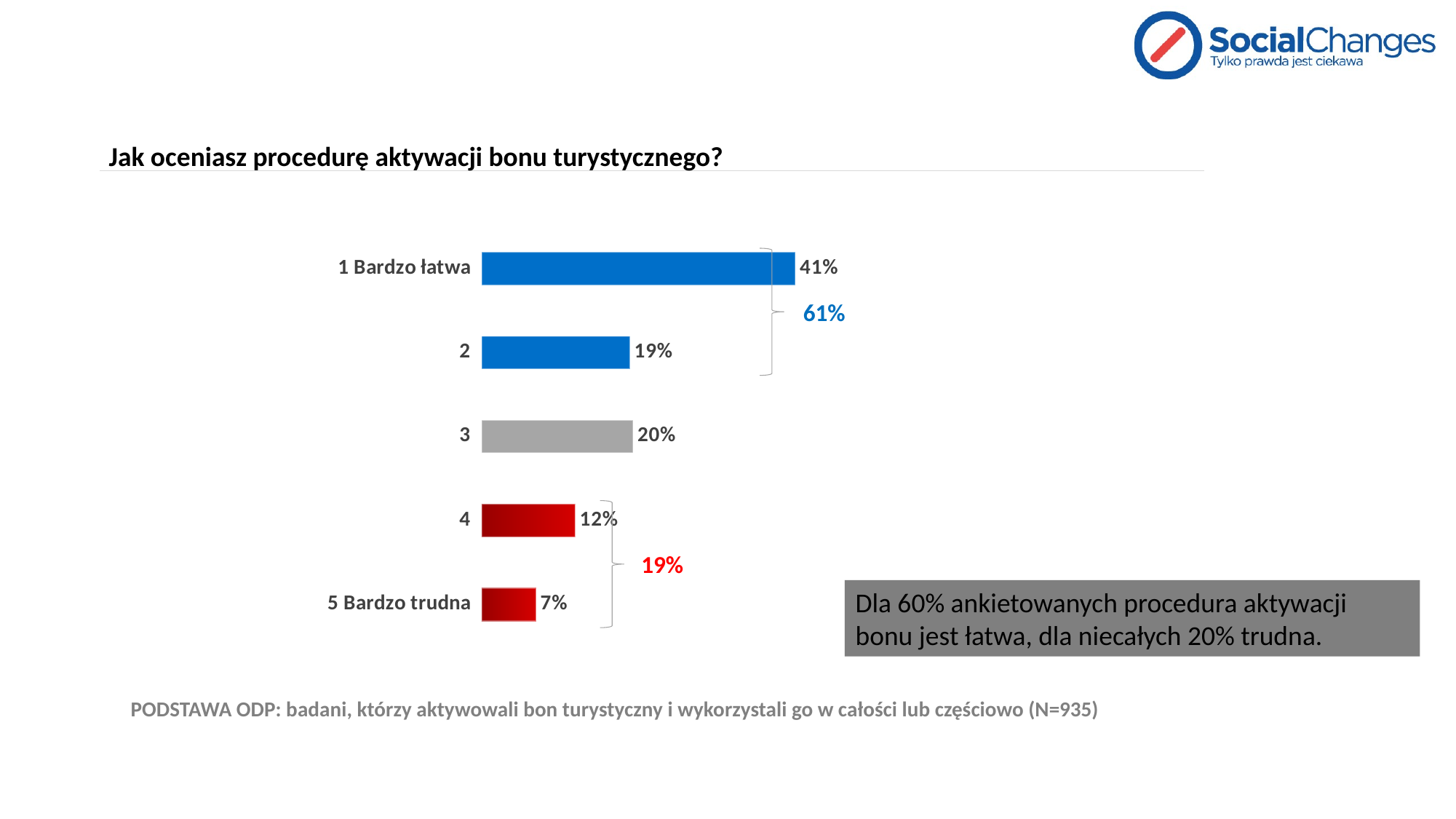
Which is larger, the value for category '4' or for '5 Bardzo trudna'? 4 Which category has the highest value? 1 Bardzo łatwa What is the value for '5 Bardzo trudna'? 7% What is the difference between the values for '1 Bardzo łatwa' and '2'? 22% What combined percentage is shown by the bracket grouping categories '4' and '5 Bardzo trudna'? 19% What is the value for '1 Bardzo łatwa'? 41% What kind of chart is shown on the slide? bar chart What is the value for category '4'? 12% Which category has the lowest value? 5 Bardzo trudna How many categories are shown in the chart? 5 What is the value for category '3'? 20% What combined percentage is shown by the bracket grouping categories '1 Bardzo łatwa' and '2'? 61%